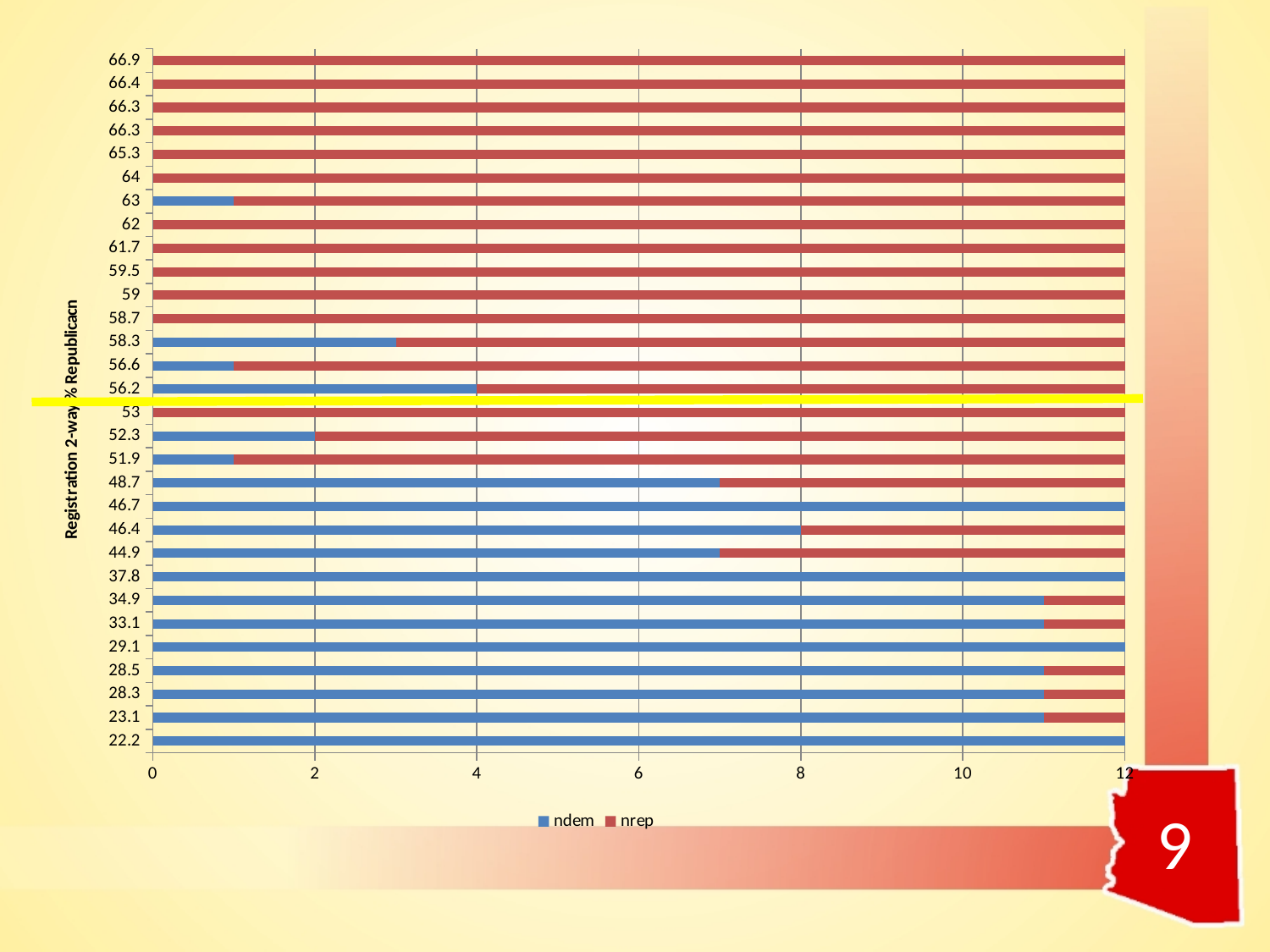
What are the two series named in the legend? ndem and nrep What is the ndem value for the category labelled 52.3? 2 Which colour represents the nrep series? red Which is larger, the ndem value for the category labelled 58.3 or the ndem value for the category labelled 63? 58.3 What kind of chart is shown on the slide? bar chart What is the total length of the stacked bar for the category labelled 66.9? 12 Is the ndem value for the category labelled 63 greater or less than 2? less What is the ndem value for the category labelled 46.4? 8 How many categories (bars) are plotted on the chart? 30 How many series does the legend list? 2 What is the ndem value for the category labelled 56.2? 4 Is the nrep value for the category labelled 66.4 greater or less than 10? greater